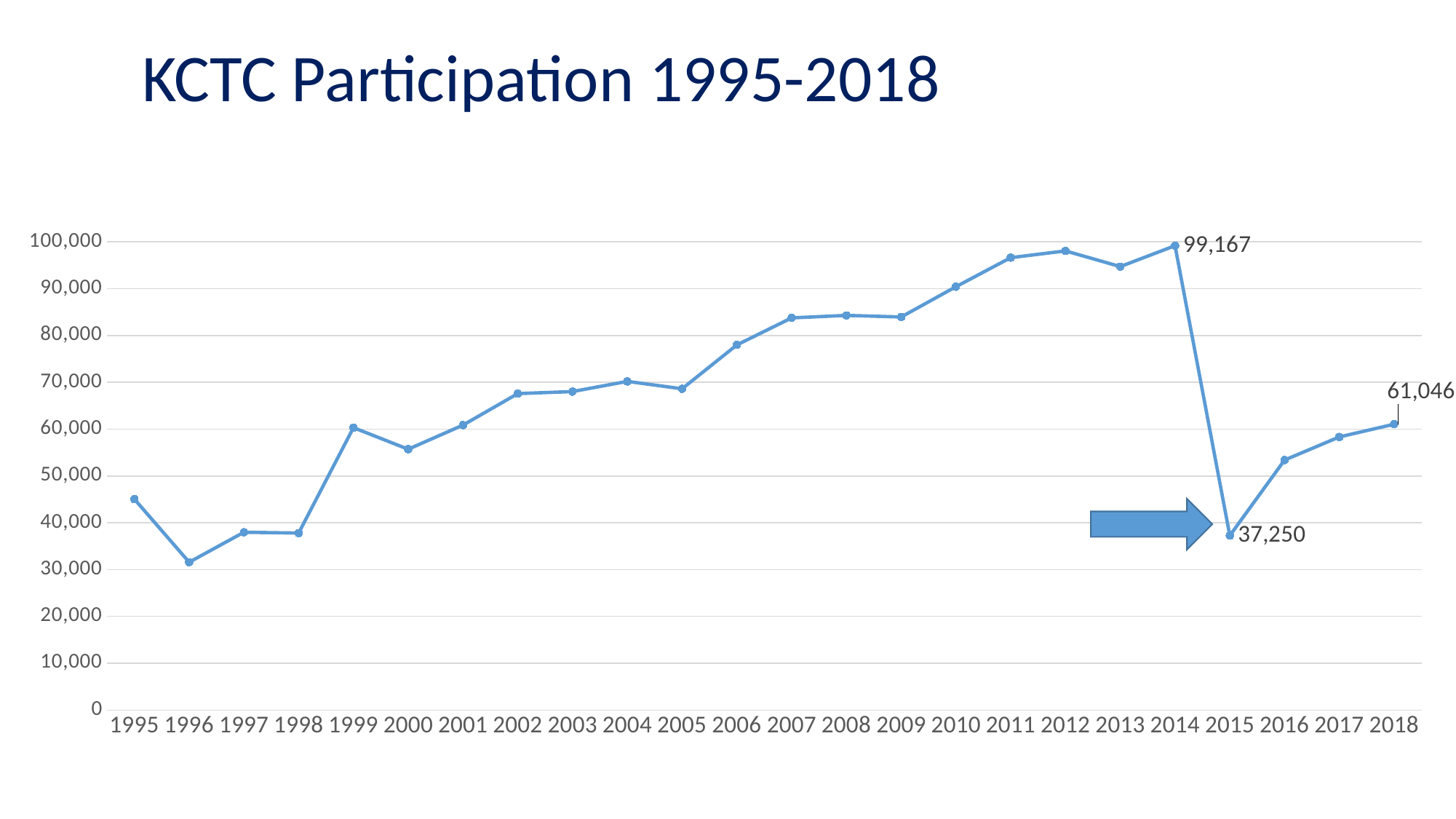
Which is larger, the value for 1995 or the value for 1996? 1995 Which year has the lowest value? 1996 Is the value for 2000 greater or less than 60,000? less Is the value for 2011 greater or less than 90,000? greater What is the difference between the 2014 value and the 2015 value? 61,917 Which year has the highest value? 2014 By how much did the value increase from 2015 to 2018? 23,796 What kind of chart is shown on the slide? line chart What is the value for 2014? 99,167 How many years are plotted on the x axis? 24 What is the value for 2015? 37,250 What is the value for 2018? 61,046